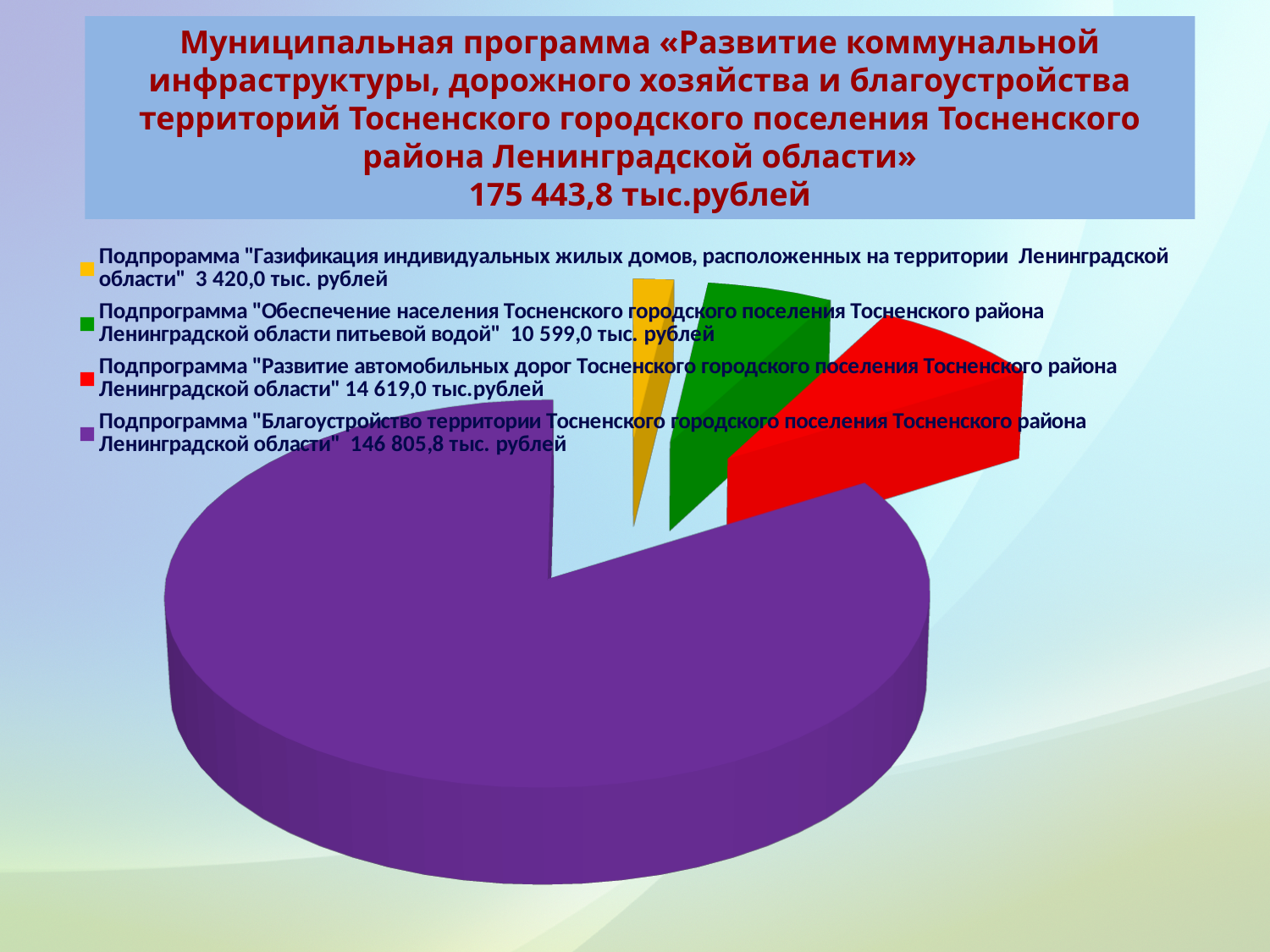
Which is larger: the value for the subprogram "Обеспечение населения питьевой водой" or the subprogram "Газификация индивидуальных жилых домов"? Обеспечение населения питьевой водой What is the value for the subprogram "Благоустройство территории Тосненского городского поселения Тосненского района Ленинградской области"? 146 805,8 тыс. рублей Which subprogram has the largest share of the pie? Благоустройство территории Тосненского городского поселения Тосненского района Ленинградской области What kind of chart is shown on the slide? pie chart What colour is the slice for the subprogram "Благоустройство территории"? purple What is the value for the subprogram "Развитие автомобильных дорог Тосненского городского поселения Тосненского района Ленинградской области"? 14 619,0 тыс.рублей What is the value for the subprogram "Газификация индивидуальных жилых домов, расположенных на территории Ленинградской области"? 3 420,0 тыс. рублей Which subprogram has the smallest share of the pie? Газификация индивидуальных жилых домов, расположенных на территории Ленинградской области How many slices does the pie chart have? 4 What is the total amount of the municipal program shown in the title? 175 443,8 тыс.рублей What is the value for the subprogram "Обеспечение населения Тосненского городского поселения Тосненского района Ленинградской области питьевой водой"? 10 599,0 тыс. рублей What is the difference between the value for the subprogram "Развитие автомобильных дорог" and the subprogram "Обеспечение населения питьевой водой"? 4 020,0 тыс. рублей